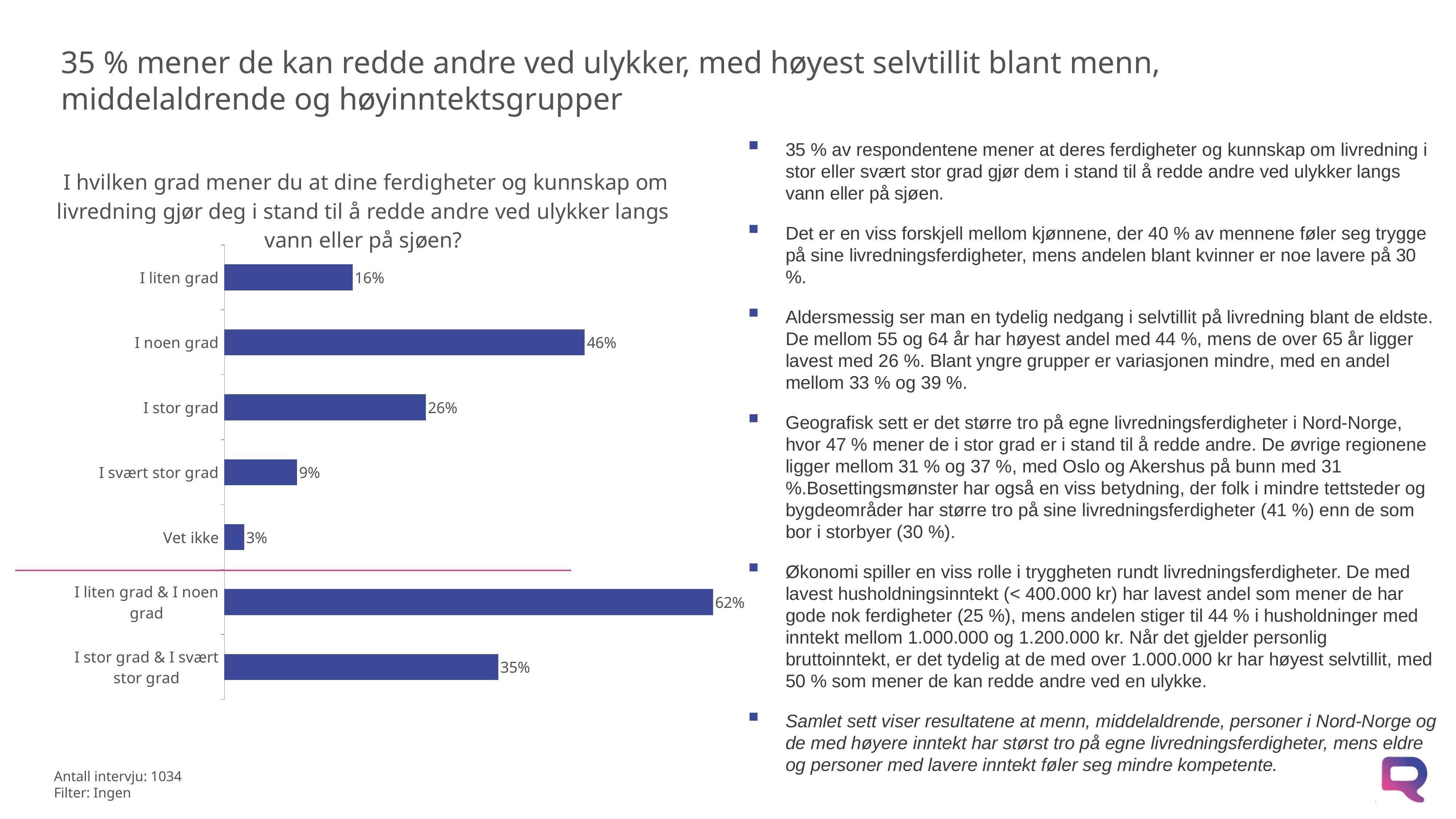
Which category has the highest value in the chart? I liten grad & I noen grad What is the value for "I stor grad & I svært stor grad"? 35% Which category has the lowest value in the chart? Vet ikke What kind of chart is shown on the slide? Bar chart What is the value for "I svært stor grad"? 9% Which is larger, "I liten grad" or "I stor grad"? I stor grad What is the value for "I noen grad"? 46% How many categories are shown in the chart? 7 What is the difference between "I noen grad" and "I stor grad"? 20 percentage points What colour are the bars in the chart? Blue What is the difference between "I liten grad & I noen grad" and "I stor grad & I svært stor grad"? 27 percentage points What is the value for "Vet ikke"? 3%